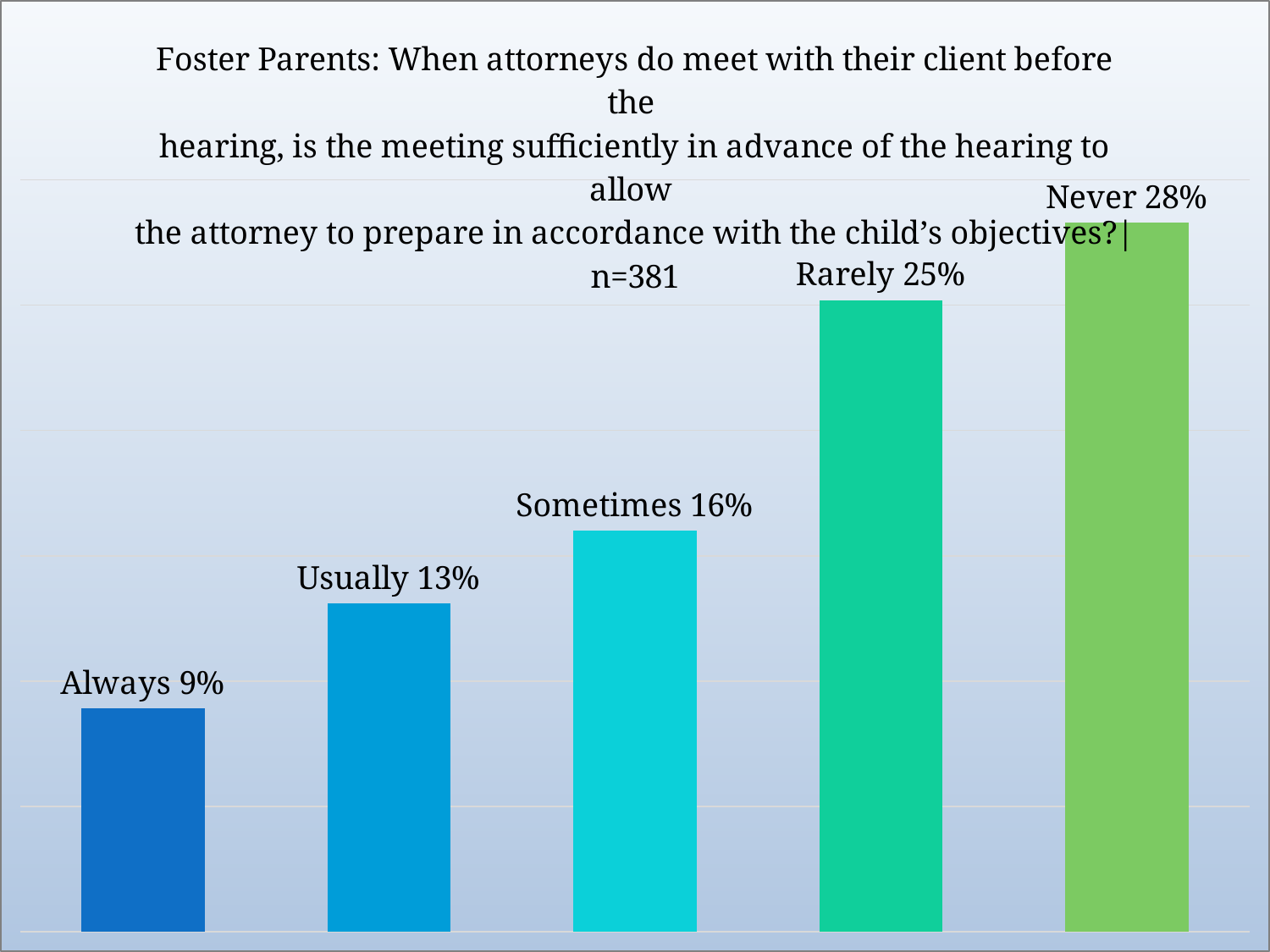
Which is larger, the value for "Usually" or the value for "Sometimes"? Sometimes What is the value shown for "Rarely"? 25% What kind of chart is shown on the slide? Bar chart How many response categories are shown in the chart? 5 What is the value shown for "Sometimes"? 16% What is the difference between the "Rarely" and "Sometimes" values? 9% Which response category has the lowest value? Always What is the difference between the "Never" and "Always" values? 19% What sample size (n) is stated in the chart title? n=381 Which response category has the highest value? Never What percentage of foster parents answered "Always"? 9% Do the values rise or fall from left to right across the categories? Rise